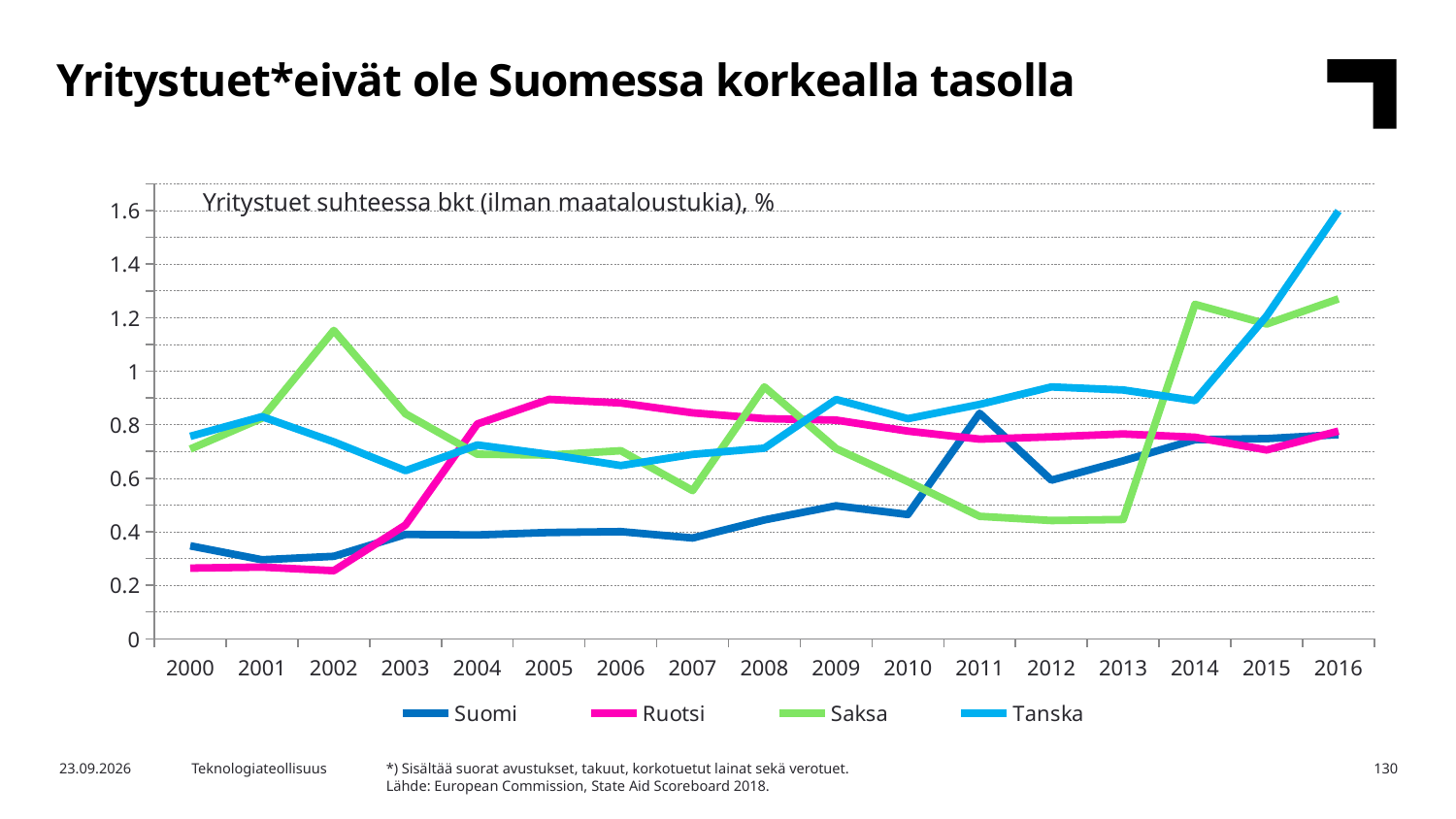
Which country has the highest value in 2002? Saksa Which country has the lowest value in 2013? Saksa Is the value for Ruotsi in 2005 greater or less than 0.8? greater Is the value for Tanska in 2016 greater or less than 1.4? greater In 2014, which is larger: the value for Saksa or the value for Suomi? Saksa Is the value for Suomi in 2000 greater or less than 0.4? less What kind of chart is shown on the slide? Line chart How many years are shown on the x axis? 17 How many series does the legend list? 4 What is the title of the chart? Yritystuet suhteessa bkt (ilman maataloustukia), % Which country has the highest value in 2016? Tanska Does the value for Tanska rise or fall from 2013 to 2016? rise